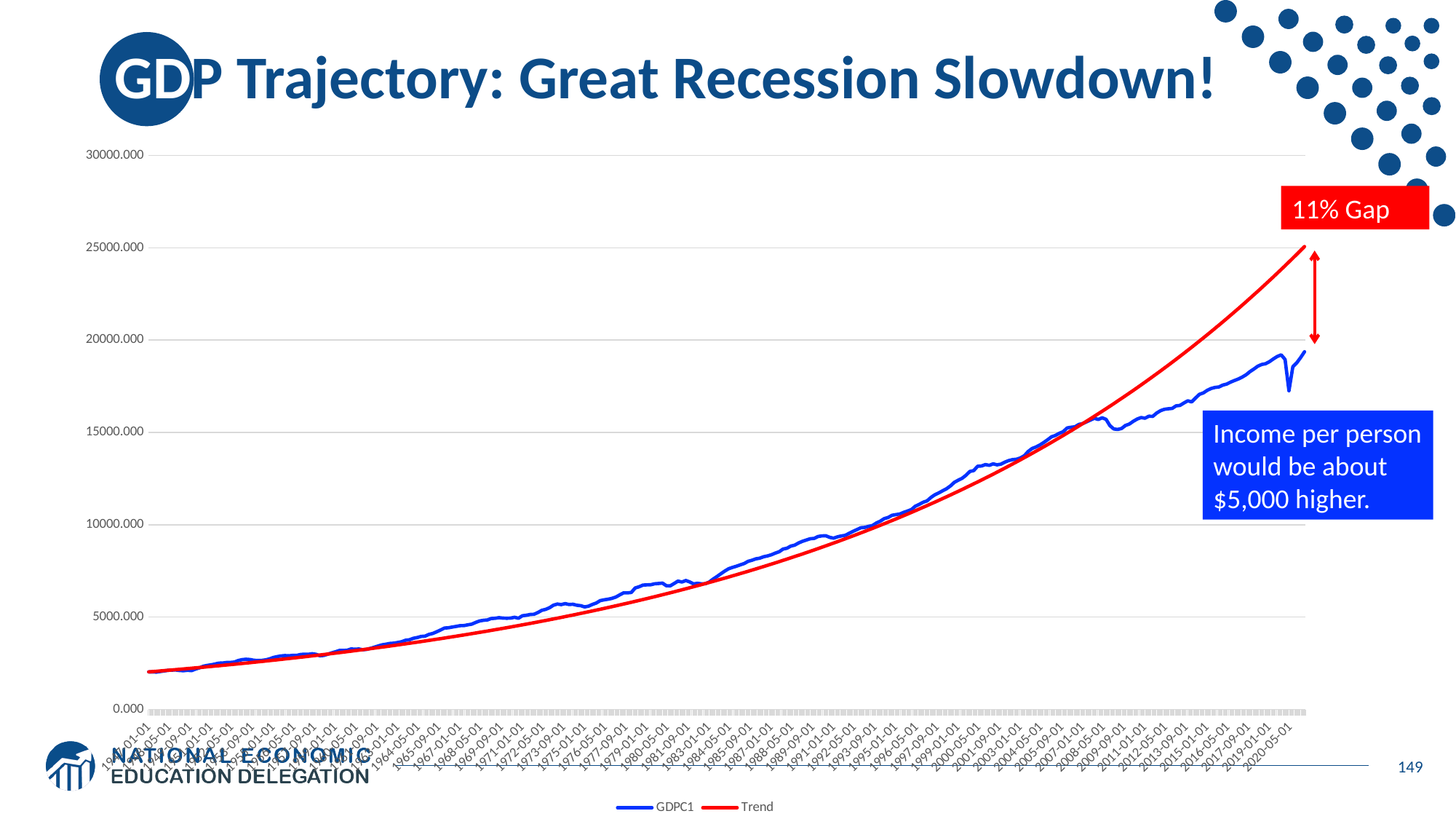
Is the value of the Trend line at the right end of the chart greater or less than 20000.000? greater What are the two series named in the chart legend? GDPC1 and Trend What is the highest value labelled on the chart's vertical axis? 30000.000 What colour is the Trend line in the chart? red Is the value of the GDPC1 line at the right end of the chart greater or less than 20000.000? less According to the annotation on the chart, what is the percentage gap between the Trend line and GDPC1 at the end of the series? 11% Gap At the right end of the chart (2020), which series is higher, GDPC1 or Trend? Trend Do the GDPC1 values generally rise or fall from left to right along the x axis? rise Is the value of the GDPC1 line around 2000-05-01 greater or less than 10000.000? greater How many series does the chart legend list? 2 What kind of chart is shown on the slide? line chart